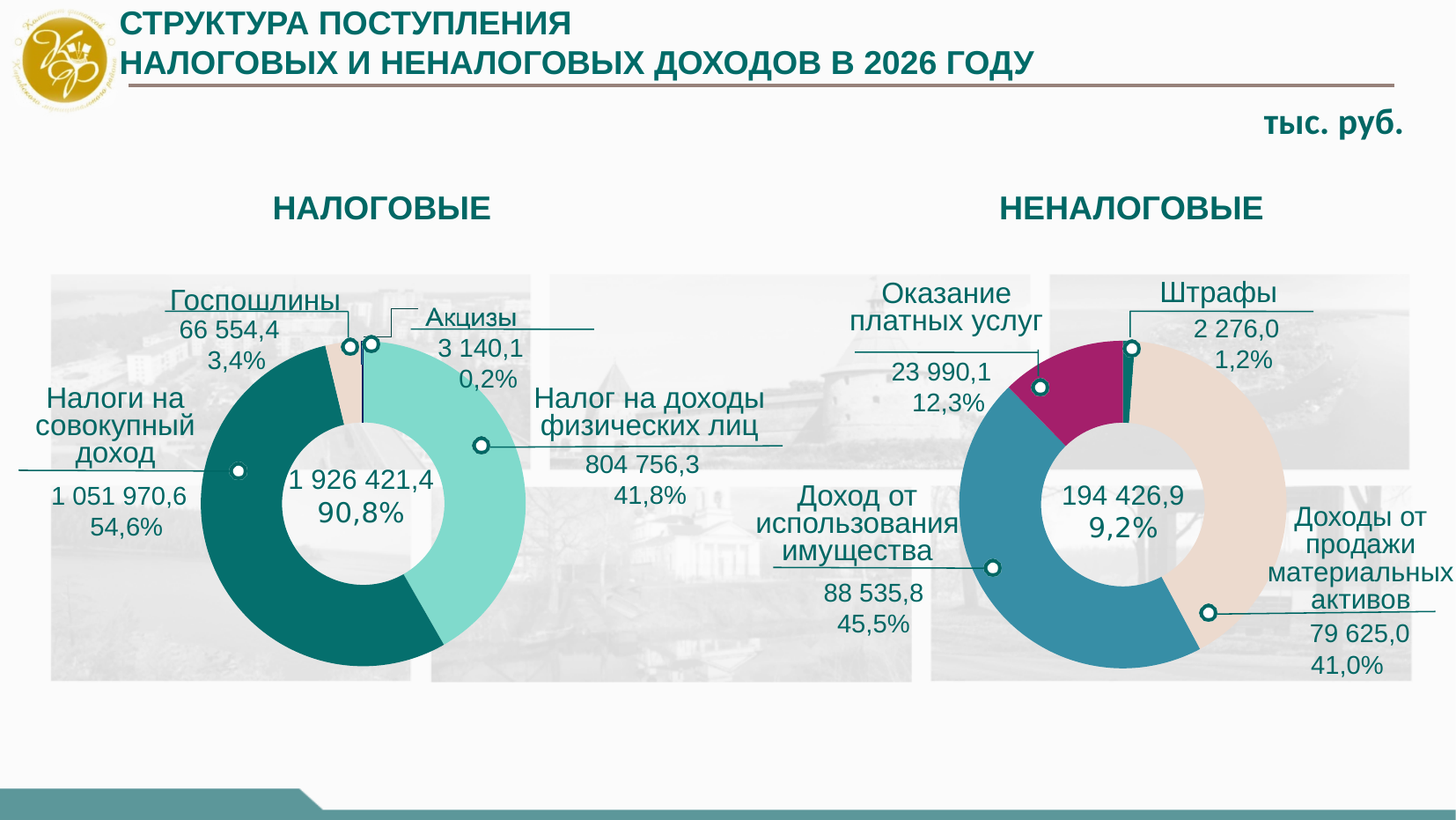
In the 'НЕНАЛОГОВЫЕ' chart, which is larger: 'Доход от использования имущества' or 'Доходы от продажи материальных активов'? Доход от использования имущества In the 'НАЛОГОВЫЕ' chart, which category has the largest value? Налоги на совокупный доход In the 'НАЛОГОВЫЕ' chart, what is the difference between 'Госпошлины' and 'Акцизы'? 63 414,3 What total value is printed in the centre of the 'НЕНАЛОГОВЫЕ' chart? 194 426,9 How many categories are shown in the 'НАЛОГОВЫЕ' chart? 4 In the 'НЕНАЛОГОВЫЕ' chart, what share does 'Штрафы' have? 1,2% In the 'НАЛОГОВЫЕ' chart, what is the value for 'Налоги на совокупный доход'? 1 051 970,6 In the 'НАЛОГОВЫЕ' chart, which category has the smallest value? Акцизы In the 'НАЛОГОВЫЕ' chart, what share does 'Налог на доходы физических лиц' have? 41,8% What kind of chart is used for the 'НАЛОГОВЫЕ' data on the slide? Pie (donut) chart In the 'НЕНАЛОГОВЫЕ' chart, what is the difference between 'Доход от использования имущества' and 'Доходы от продажи материальных активов'? 8 910,8 In the 'НЕНАЛОГОВЫЕ' chart, what is the value for 'Оказание платных услуг'? 23 990,1